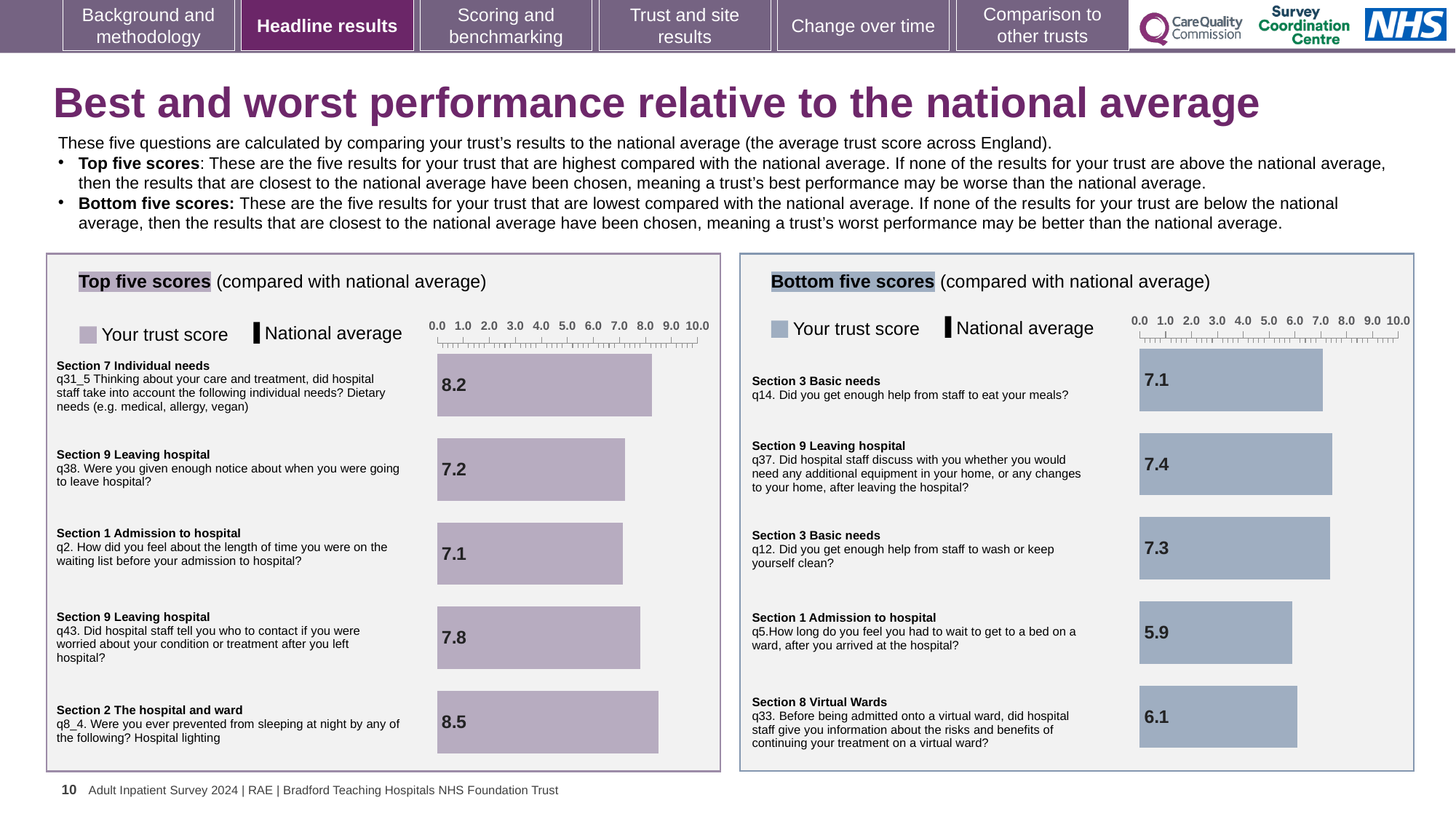
In the Top five scores chart, what is the trust score for q31_5 (Dietary needs)? 8.2 In the Bottom five scores chart, which question has the lowest trust score? q5 (wait to get to a bed on a ward), 5.9 In the Top five scores chart, which question has the highest trust score? q8_4 (Hospital lighting), 8.5 In the Top five scores chart, is the trust score for q43 (who to contact if worried after leaving hospital) greater or less than 7.0? greater In the Bottom five scores chart, what is the difference between the score for q14 (help to eat your meals) and the score for q33 (virtual ward information)? 1.0 In the Top five scores chart, what is the difference between the score for q8_4 (Hospital lighting) and the score for q2 (waiting list before admission)? 1.4 How many questions (bars) are shown in the Top five scores chart? 5 In the Bottom five scores chart, what is the trust score for q5 (How long do you feel you had to wait to get to a bed on a ward)? 5.9 In the Bottom five scores chart, which has the larger trust score: q37 (additional equipment in your home) or q12 (help to wash or keep yourself clean)? q37 (7.4) What type of chart is used in the Bottom five scores panel? Bar chart In the Top five scores chart, what is the trust score for q38 (Were you given enough notice about when you were going to leave hospital?)? 7.2 What two entries does the legend of the Top five scores chart list? Your trust score; National average